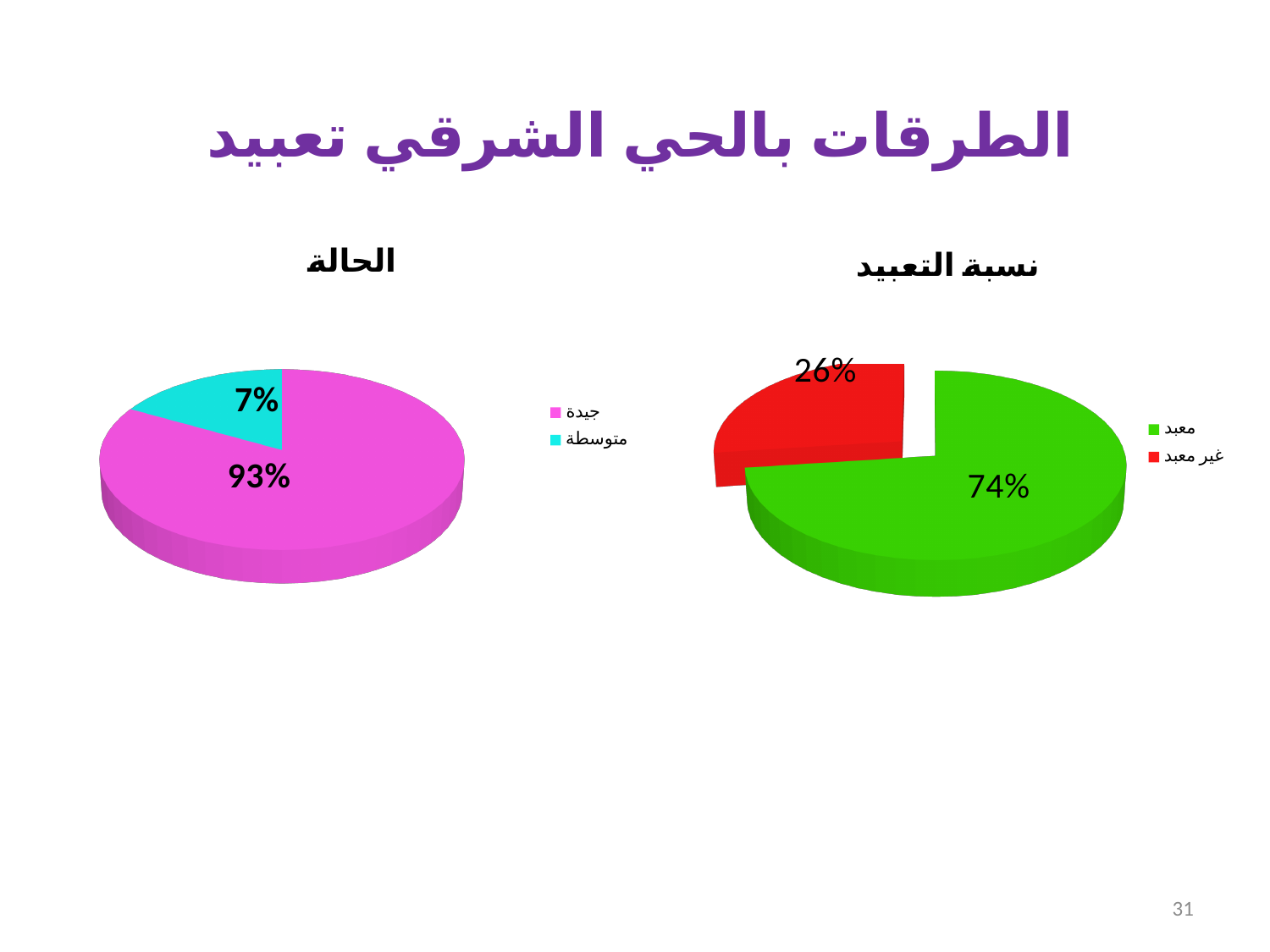
In the chart titled "نسبة التعبيد" (right), what is the difference in percentage points between "معبد" and "غير معبد"? 48 In the chart titled "الحالة" (left), what colour is the slice for "متوسطة"? Cyan In the chart titled "نسبة التعبيد" (right), what percentage is shown for "معبد"? 74% In the chart titled "الحالة" (left), what is the difference in percentage points between "جيدة" and "متوسطة"? 86 How many categories does the legend of the chart titled "نسبة التعبيد" (right) list? 2 In the chart titled "نسبة التعبيد" (right), which category has the smallest slice? غير معبد In the chart titled "الحالة" (left), which category has the largest slice? جيدة What type of chart is the chart titled "الحالة" (left)? Pie chart In the chart titled "الحالة" (left), what percentage is shown for "متوسطة"? 7% In the chart titled "الحالة" (left), what percentage is shown for "جيدة"? 93% In the chart titled "نسبة التعبيد" (right), what percentage is shown for "غير معبد"? 26% In the chart titled "نسبة التعبيد" (right), which is larger: "معبد" or "غير معبد"? معبد